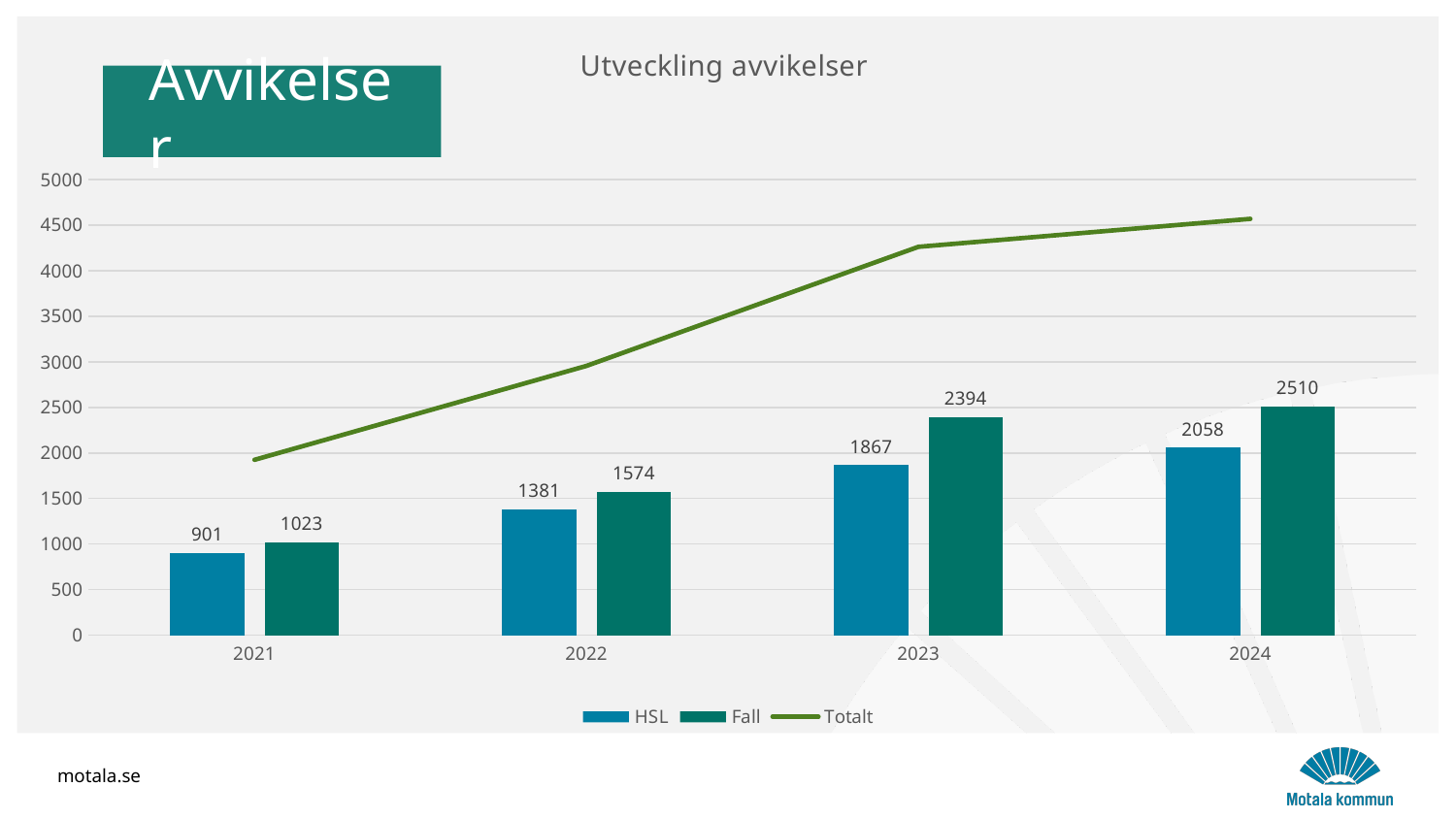
What is the value for Fall in 2023? 2394 How many series does the legend list? 3 How many years are shown on the x axis? 4 Does the Totalt line rise or fall from 2021 to 2024? rise In which year is the Fall value highest? 2024 In which year is the HSL value lowest? 2021 Which is larger in 2023, HSL or Fall? Fall What is the difference between the Fall and HSL values in 2022? 193 What is the value for HSL in 2024? 2058 What is the value for HSL in 2021? 901 Is the Totalt value for 2024 greater or less than 4500? greater